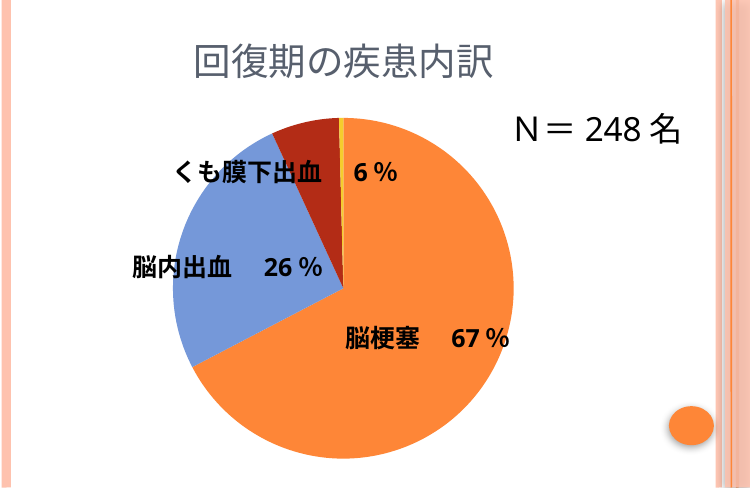
Which category has the largest slice of the pie? 脳梗塞 What share of the pie does 脳内出血 account for? 26% What is the difference in percentage points between the shares for 脳梗塞 and 脳内出血? 41 What share of the pie does くも膜下出血 account for? 6% Is the share for 脳梗塞 greater or less than 50%? greater What kind of chart is shown on the slide? pie chart What share of the pie does 脳梗塞 account for? 67% What is the value of N shown on the slide? 248名 Which is larger, the share for 脳内出血 or the share for くも膜下出血? 脳内出血 What is the difference in percentage points between the shares for 脳内出血 and くも膜下出血? 20 What is the title of the chart? 回復期の疾患内訳 How many slices of the pie have a category label? 3